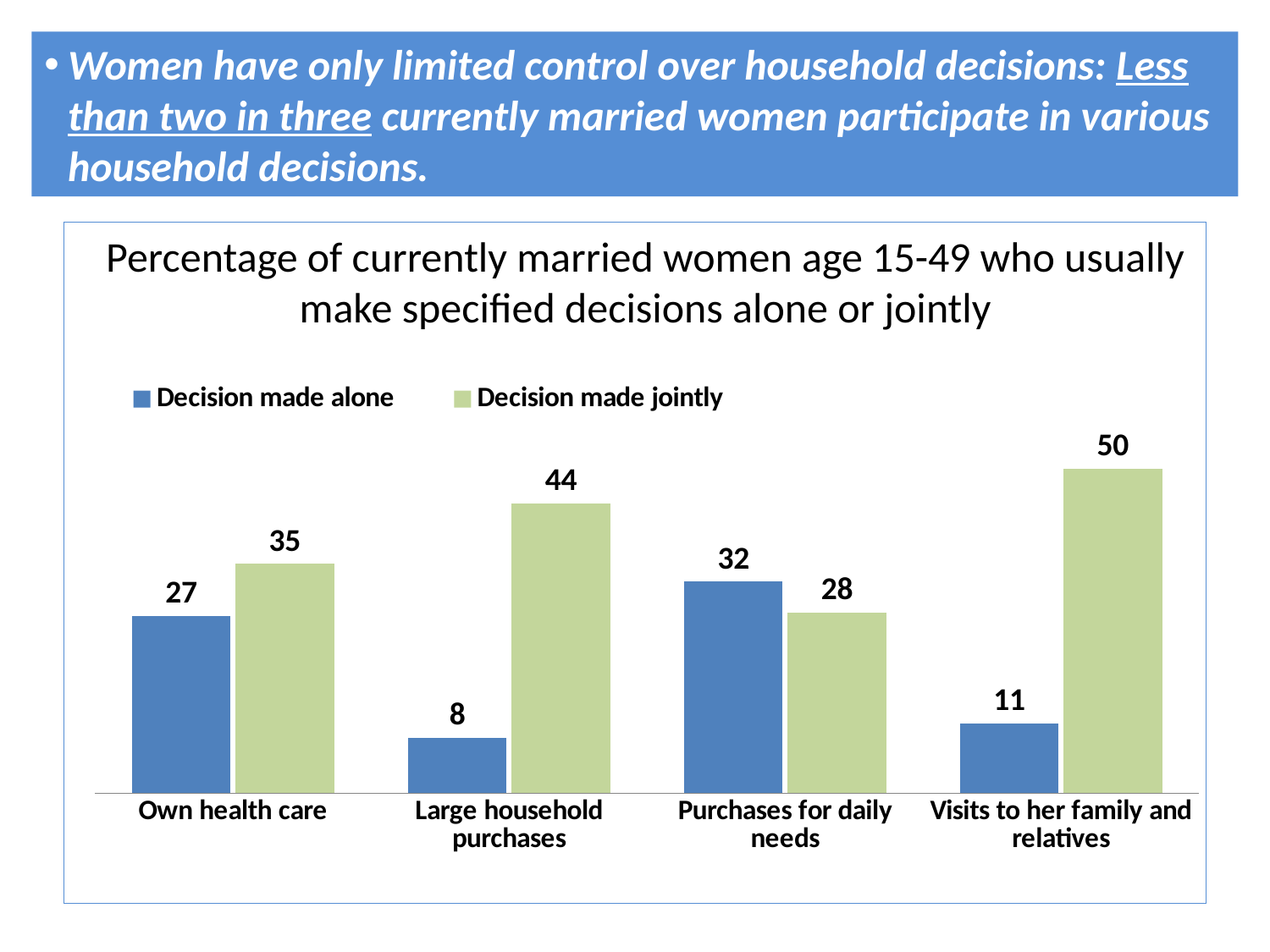
What is the title of the chart? Percentage of currently married women age 15-49 who usually make specified decisions alone or jointly What is the difference between 'Decision made jointly' and 'Decision made alone' for Large household purchases? 36 For Purchases for daily needs, which is larger: 'Decision made alone' or 'Decision made jointly'? Decision made alone What is the value for 'Decision made jointly' for Large household purchases? 44 What is the difference between 'Decision made alone' for Purchases for daily needs and for Visits to her family and relatives? 21 What is the value for 'Decision made alone' for Visits to her family and relatives? 11 How many series does the legend list? 2 Which category has the highest value for 'Decision made jointly'? Visits to her family and relatives Which category has the lowest value for 'Decision made alone'? Large household purchases What kind of chart is shown on the slide? Bar chart How many categories are shown on the x axis? 4 What is the value for 'Decision made alone' for Own health care? 27